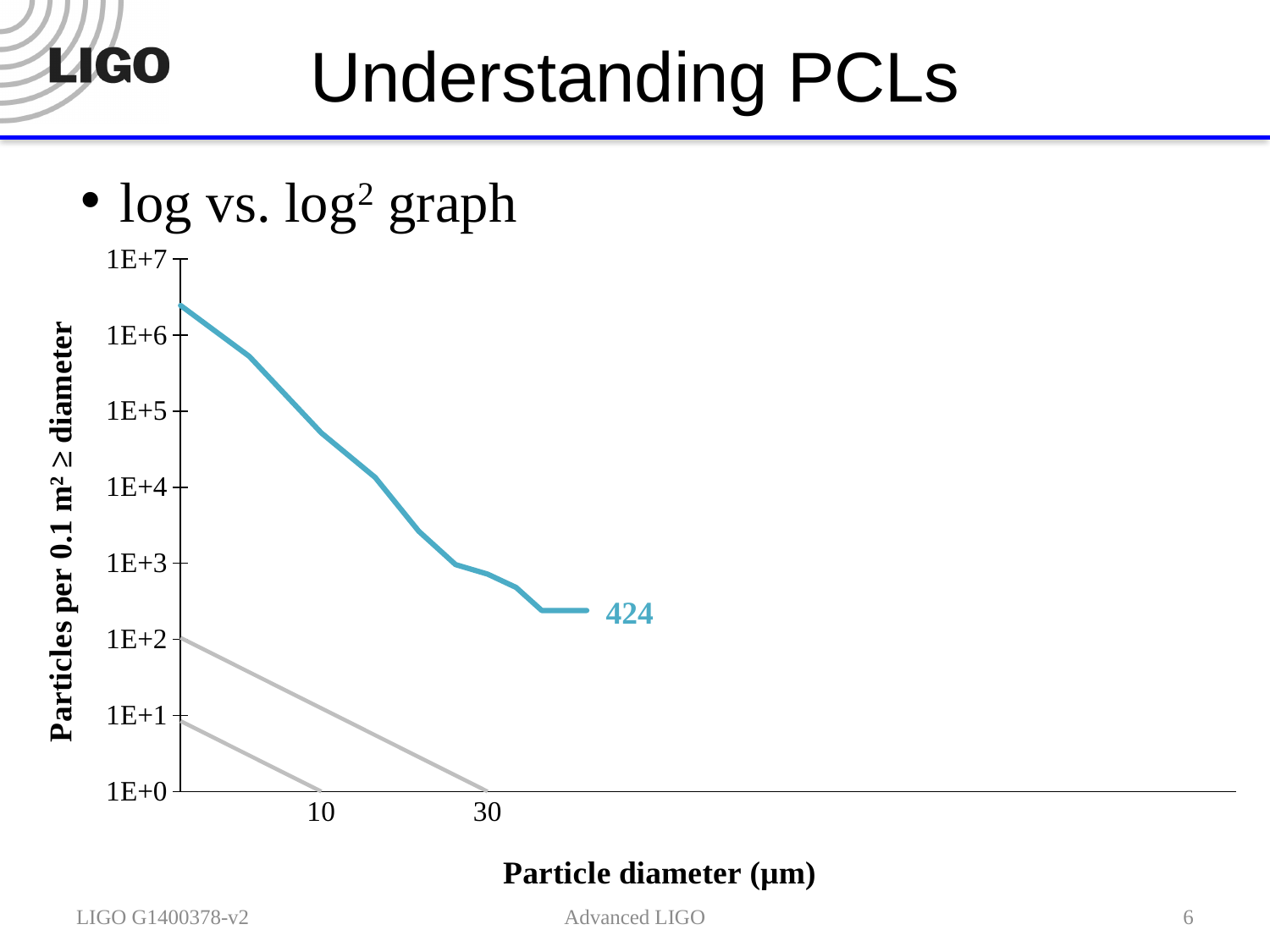
What is the title of the y axis? Particles per 0.1 m² ≥ diameter Is the value of the blue line at its left-hand starting point greater or less than 1E+6? greater What kind of chart is shown on the slide? line chart What is the title of the x axis? Particle diameter (µm) Is the value of the blue line at a particle diameter of 10 µm greater or less than 1E+4? greater At what particle diameter does the lower gray line reach 1E+0? 10 How many lines are plotted on the chart? 3 Does the blue line rise or fall as particle diameter increases? fall Is the value of the blue line at a particle diameter of 10 µm greater or less than 1E+5? less What value is labelled at the right end of the blue line? 424 At what particle diameter does the upper gray line reach 1E+0? 30